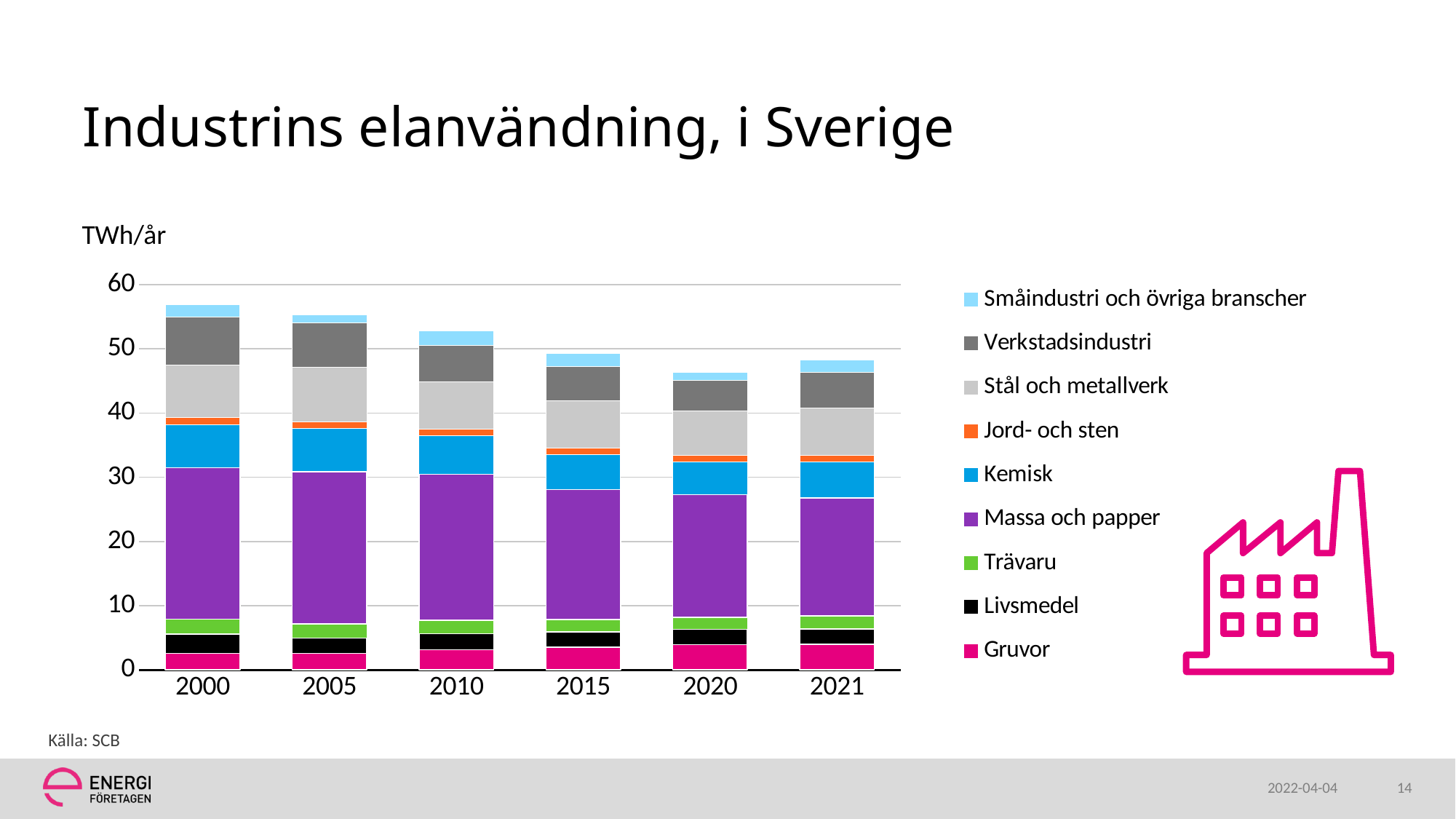
What unit is shown on the chart's y axis? TWh/år What kind of chart is shown on the slide? stacked bar chart Is the total bar for 2000 greater or less than 50 TWh/år? greater How many series does the chart's legend list? 9 Do the total bars generally rise or fall from 2000 to 2020? fall Which year has the larger total bar, 2000 or 2021? 2000 Is the total bar for 2021 greater or less than 50 TWh/år? less How many years are shown on the x axis of the chart? 6 What is the title of the chart on the slide? Industrins elanvändning, i Sverige Which year has the highest total industrial electricity use in the chart? 2000 Which year has the lowest total industrial electricity use in the chart? 2020 Is the total bar for 2020 greater or less than 50 TWh/år? less